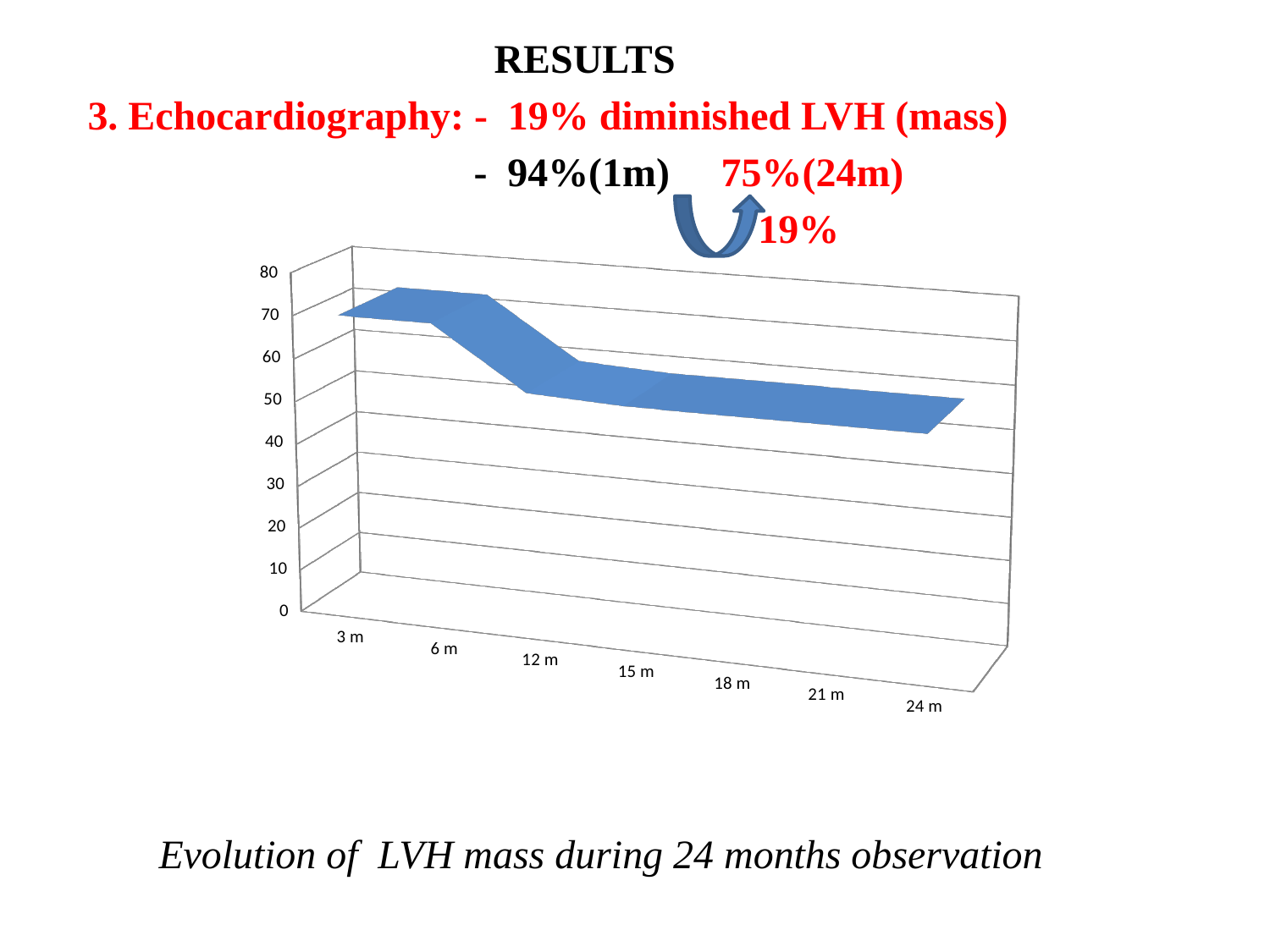
Which is larger, the value at 3 m or the value at 24 m? 3 m What is the first time point label on the x axis? 3 m Which is larger, the value at 6 m or the value at 15 m? 6 m Is the value at 3 m greater or less than 60? greater What kind of chart is shown on the slide? 3D line chart How many time points are shown on the x axis of the chart? 7 Is the value at 12 m greater or less than 70? less Is the value at 24 m greater or less than 60? less Do the values in the chart rise or fall from 3 m to 24 m? fall What is the highest value shown on the vertical axis of the chart? 80 What is the caption below the chart? Evolution of LVH mass during 24 months observation